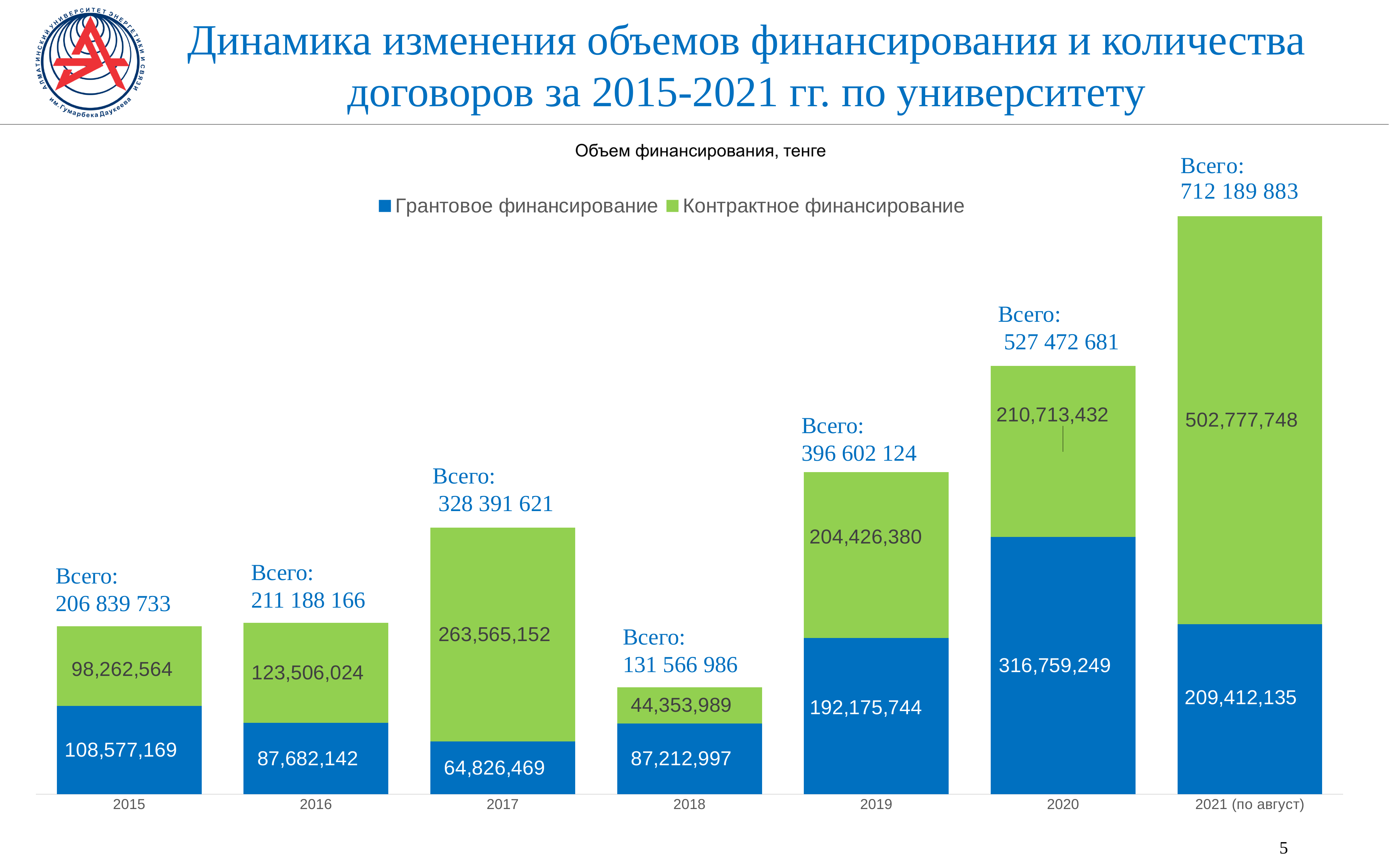
Which year has the lowest total funding (Всего)? 2018 What kind of chart is shown on the slide? Stacked bar chart What is the grant funding value for 2020? 316,759,249 How many years are shown on the x axis? 7 What is the difference between grant funding and contract funding in 2020? 106,045,817 In 2016, which is larger: grant funding or contract funding? Contract funding What is the total funding (Всего) for 2019? 396 602 124 Which year has the highest contract funding? 2021 (по август) Which year has the lowest grant funding? 2017 What is the contract funding (Контрактное финансирование) value for 2017? 263,565,152 How many series does the legend list? 2 What is the grant funding (Грантовое финансирование) value for 2015? 108,577,169